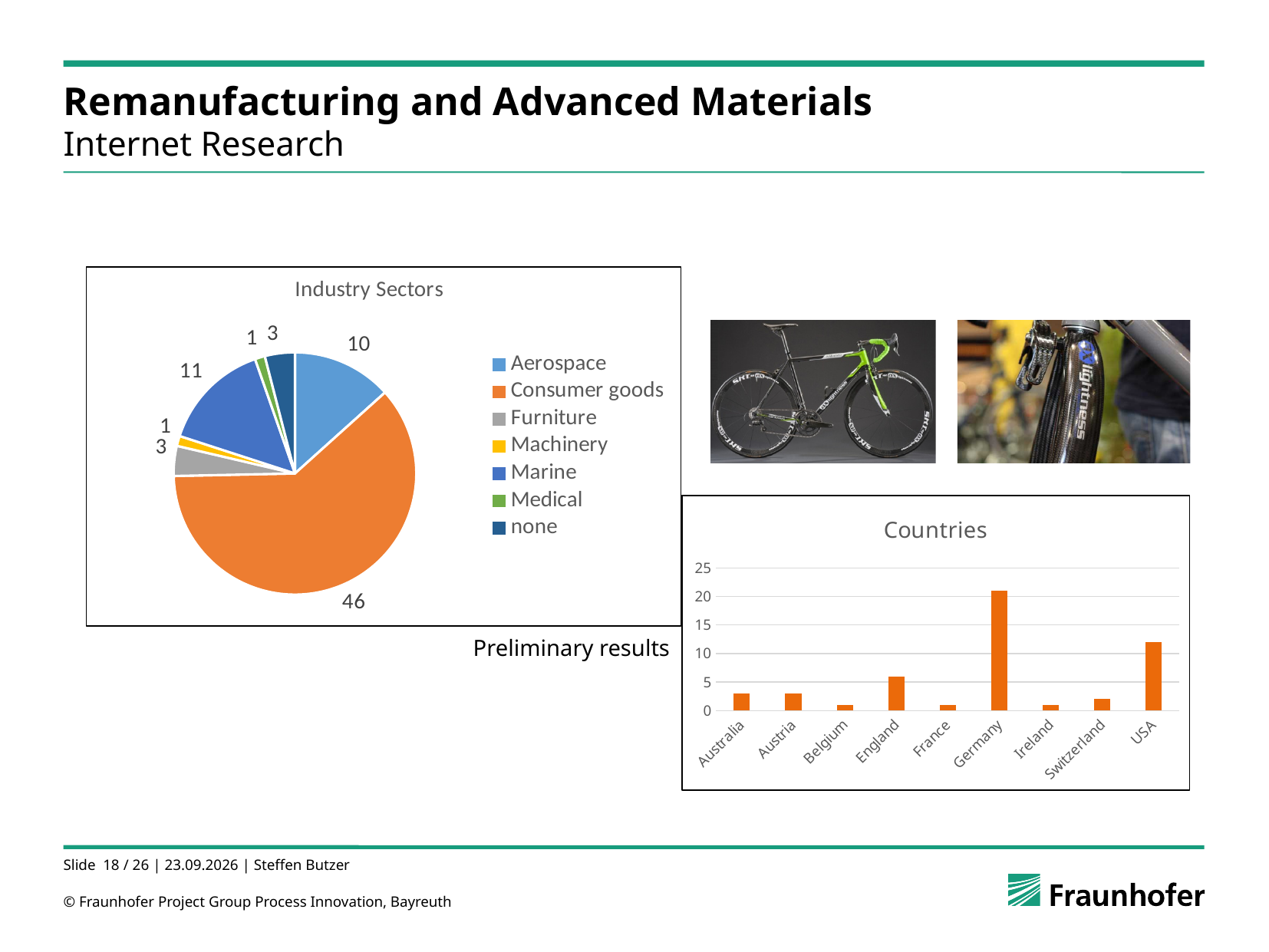
On the Industry Sectors pie chart, what is the value for Consumer goods? 46 On the Industry Sectors pie chart, what is the difference between Consumer goods and Marine? 35 What kind of chart is the Countries chart? Bar chart On the Industry Sectors pie chart, which sector has the largest slice? Consumer goods How many categories does the legend of the Industry Sectors chart list? 7 How many countries are shown on the Countries chart? 9 On the Industry Sectors pie chart, which is larger, Aerospace or Marine? Marine On the Countries chart, is the value for USA greater or less than 10? greater On the Industry Sectors pie chart, what is the value for Marine? 11 What kind of chart is the Industry Sectors chart? Pie chart On the Countries chart, which country has the highest bar? Germany On the Industry Sectors pie chart, what is the value for Aerospace? 10